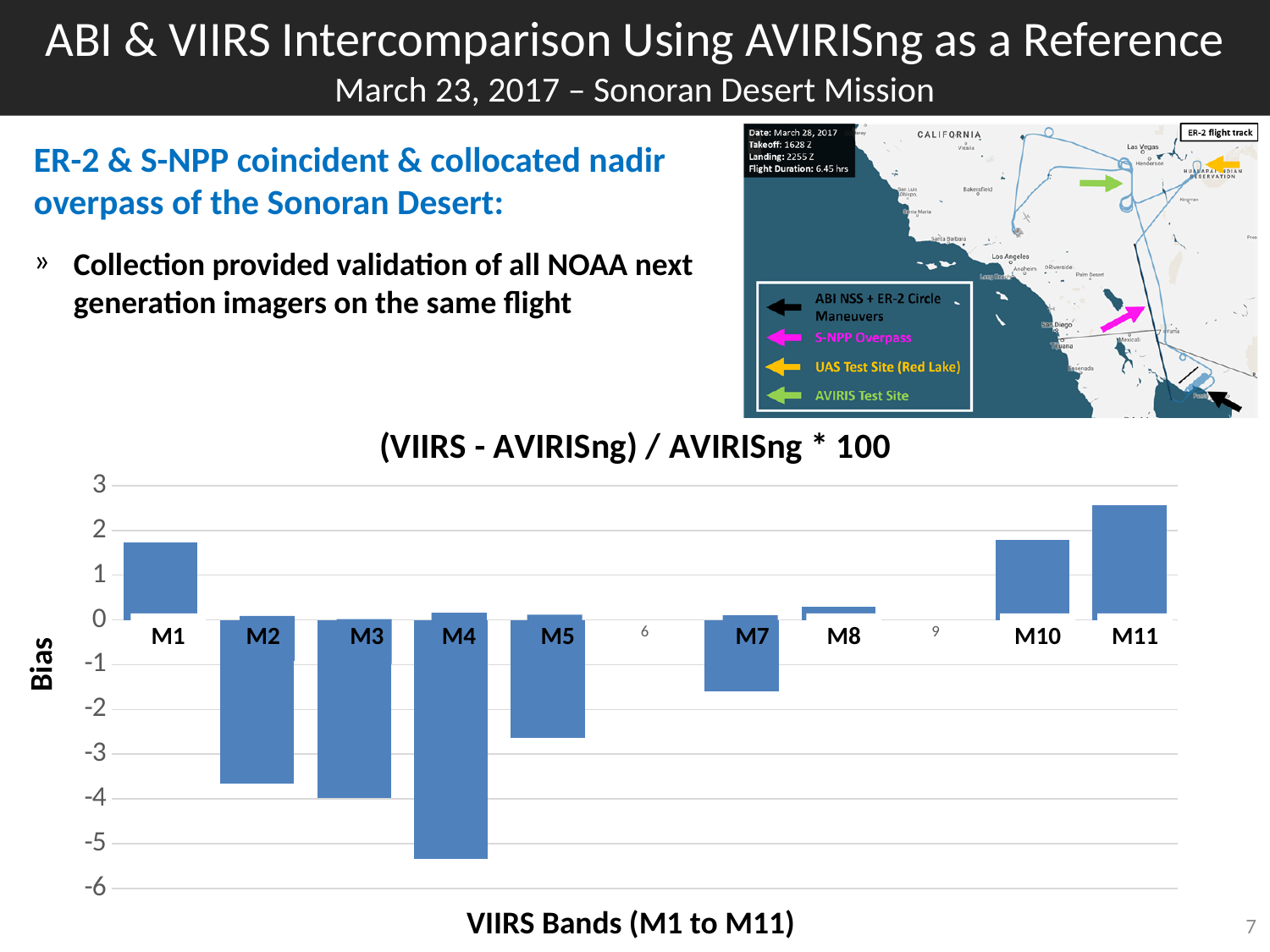
Is the bias value for M1 greater or less than 1? greater Is the bias value for M7 greater or less than -2? greater What kind of chart is shown on the slide? bar chart Which VIIRS band has the lowest bias value in the chart? M4 Is the bias value for M4 greater or less than -5? less What is the title of the chart? (VIIRS - AVIRISng) / AVIRISng * 100 What is the label of the y axis of the chart? Bias Which VIIRS band has the highest bias value in the chart? M11 Which has the larger bias value, M5 or M7? M7 How many bars are drawn in the chart? 9